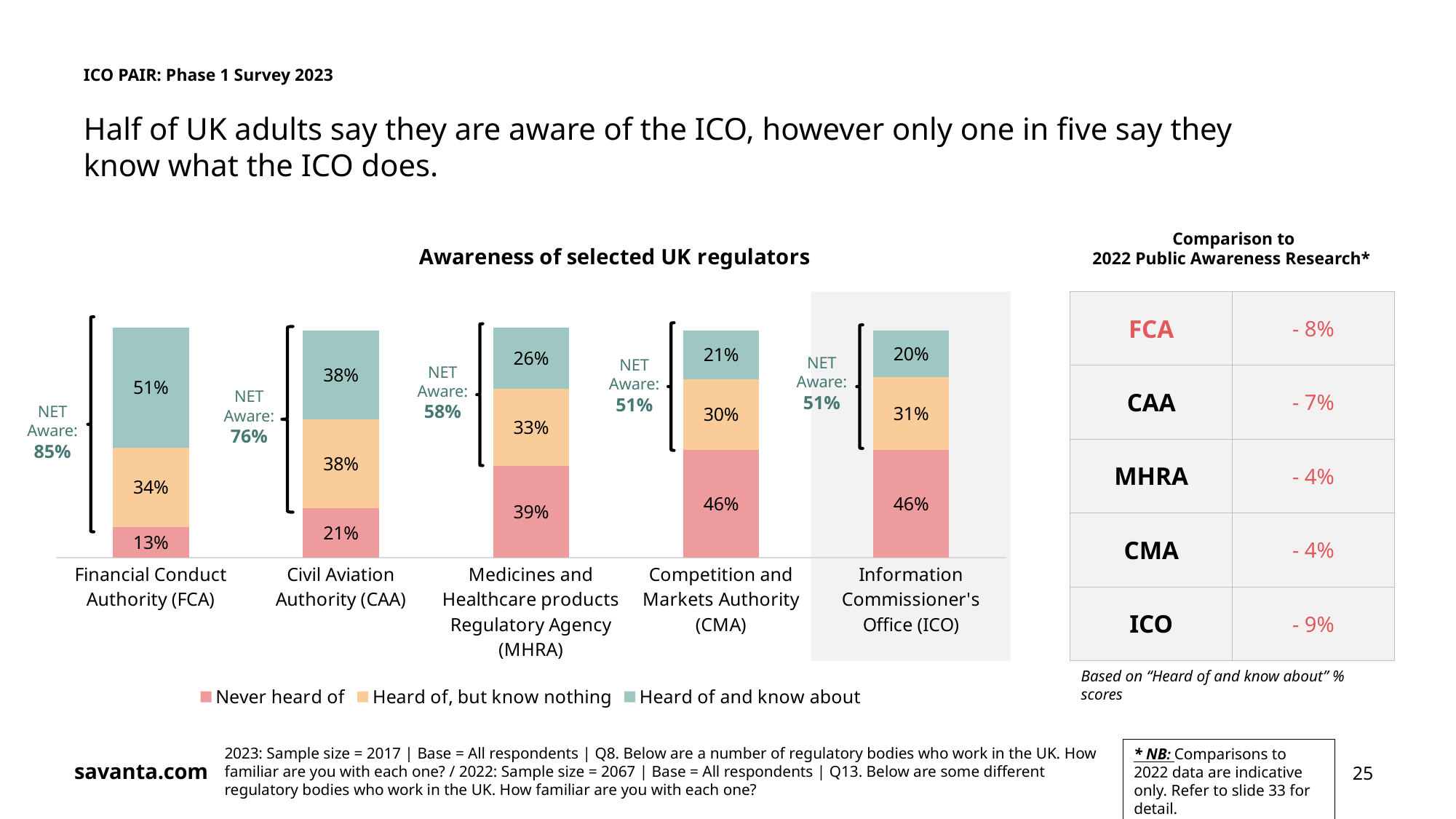
Which regulator has the lowest 'Never heard of' percentage? Financial Conduct Authority (FCA) How many series does the chart legend list? 3 How many regulators are shown on the x axis of the chart? 5 What kind of chart is 'Awareness of selected UK regulators'? Stacked bar chart What percentage of respondents said they had 'Never heard of' the Financial Conduct Authority (FCA)? 13% Which regulator's bar is highlighted with a grey background on the chart? Information Commissioner's Office (ICO) Which has a larger 'Never heard of' percentage, the MHRA or the CMA? Competition and Markets Authority (CMA) Do the 'Heard of and know about' values rise or fall moving from left to right across the regulators? Fall What is the difference in percentage points between the 'Heard of and know about' values for the FCA and the ICO? 31 percentage points What percentage of respondents said they have 'Heard of and know about' the Information Commissioner's Office (ICO)? 20% What is the NET Aware figure shown for the Civil Aviation Authority (CAA)? 76% Which regulator has the highest 'Heard of and know about' percentage? Financial Conduct Authority (FCA)